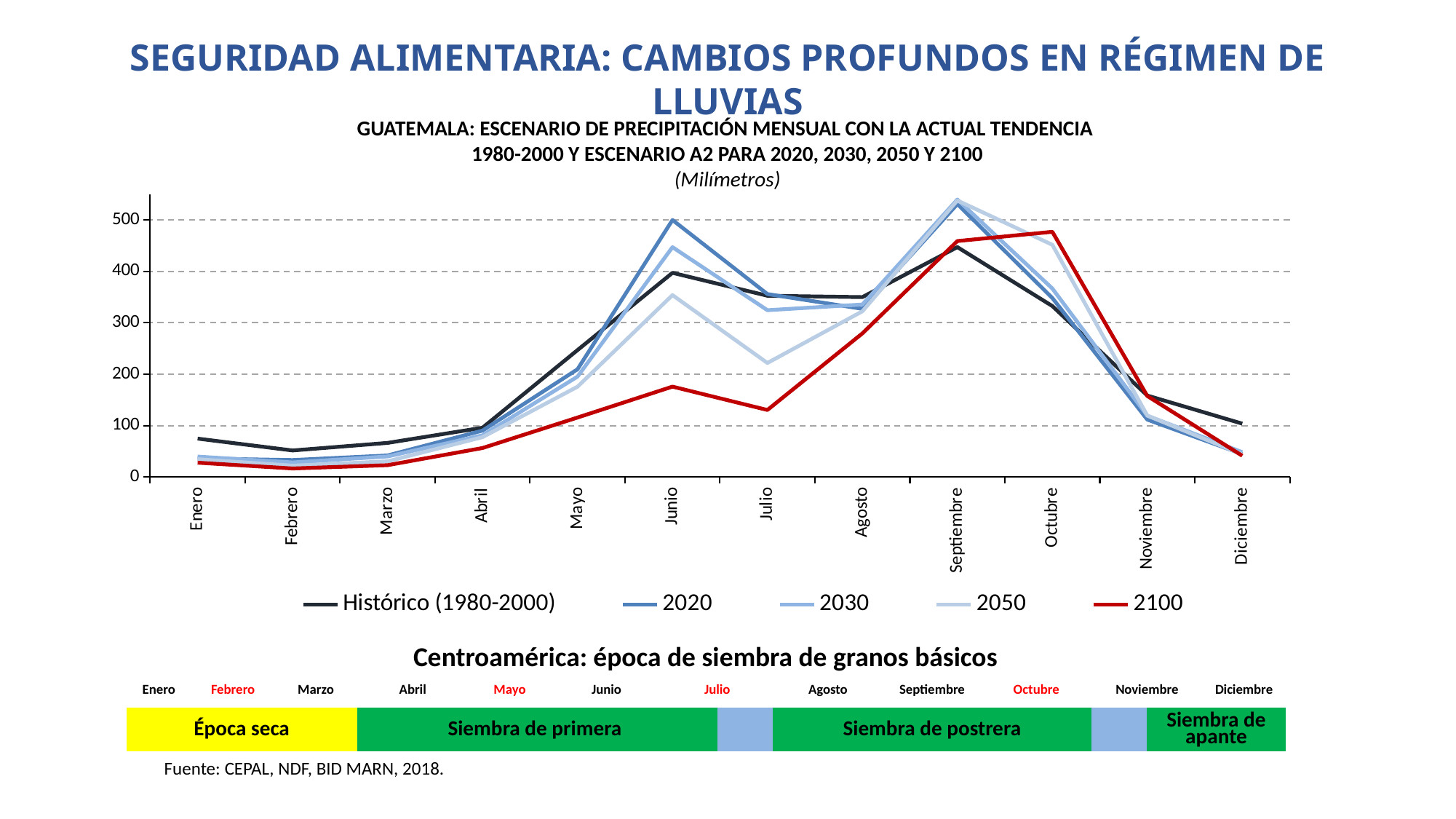
What colour is the line for the 2100 series in the chart? red Is the value for the 2100 series in Octubre greater or less than 400? greater Is the value for the Histórico (1980-2000) series in Junio greater or less than 300? greater In Junio, which series has the larger value: Histórico (1980-2000) or 2100? Histórico (1980-2000) In which month does the Histórico (1980-2000) series have its lowest value? Febrero How many series does the chart legend list? 5 What kind of chart is shown on the slide? line chart How many months are plotted along the x axis of the chart? 12 Does the Histórico (1980-2000) series rise or fall from Septiembre to Diciembre? fall In which month does the Histórico (1980-2000) series reach its highest value? Septiembre Is the value for the 2100 series in Junio greater or less than 200? less